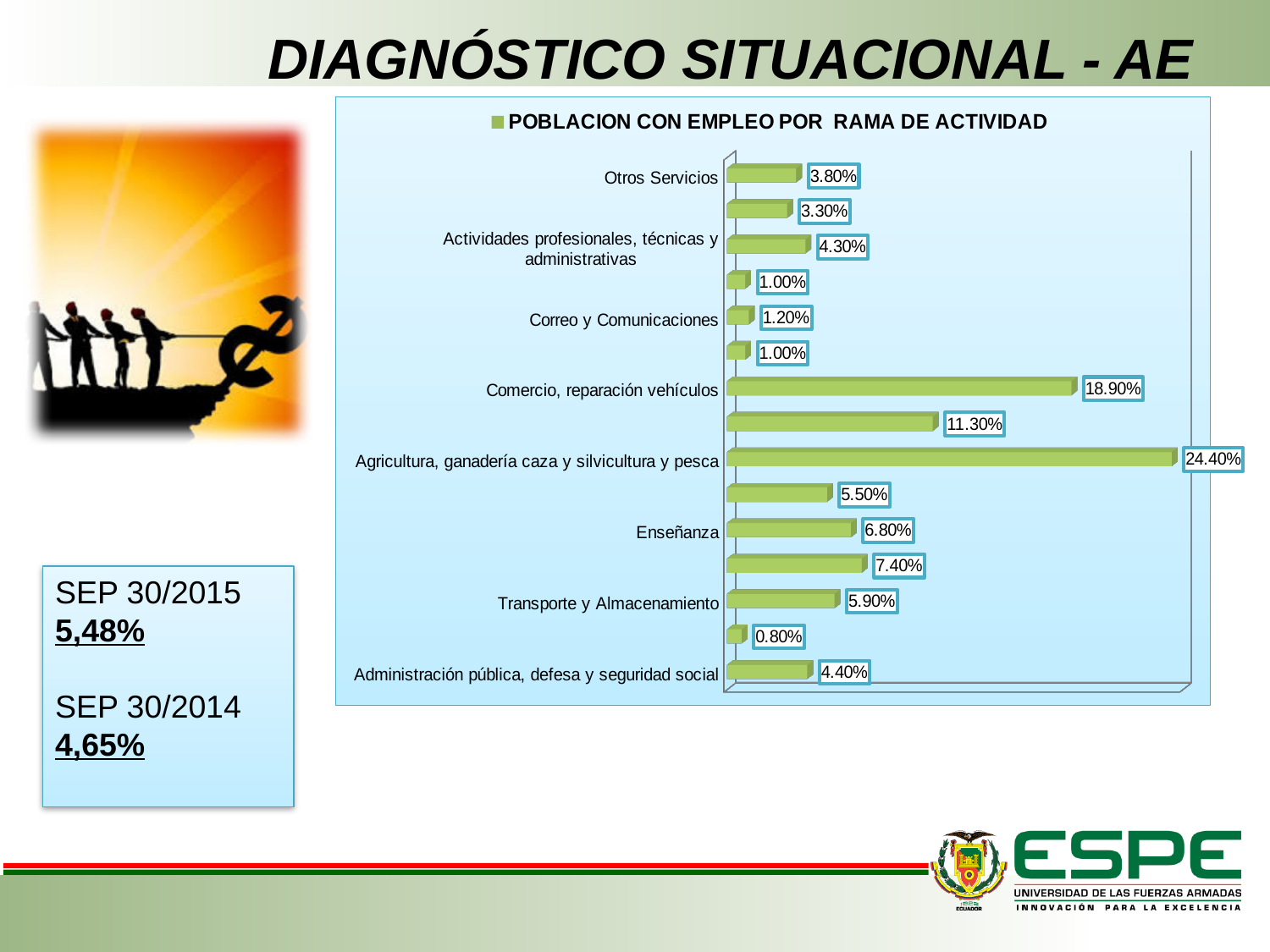
Which is larger, the value for Transporte y Almacenamiento or the value for Otros Servicios? Transporte y Almacenamiento What is the lowest value shown on any bar in the chart? 0.80% What is the value for Comercio, reparación vehículos? 18.90% What type of chart is shown on the slide? bar chart What is the value for Administración pública, defensa y seguridad social? 4.40% How many bars are plotted in the chart? 15 What is the difference between the values for Agricultura, ganadería caza y silvicultura y pesca and Comercio, reparación vehículos? 5.50% What is the value for Enseñanza? 6.80% Which labeled category has the highest value? Agricultura, ganadería caza y silvicultura y pesca What is the series name shown in the chart legend? POBLACION CON EMPLEO POR RAMA DE ACTIVIDAD What is the value for Agricultura, ganadería caza y silvicultura y pesca? 24.40% What is the value for Correo y Comunicaciones? 1.20%